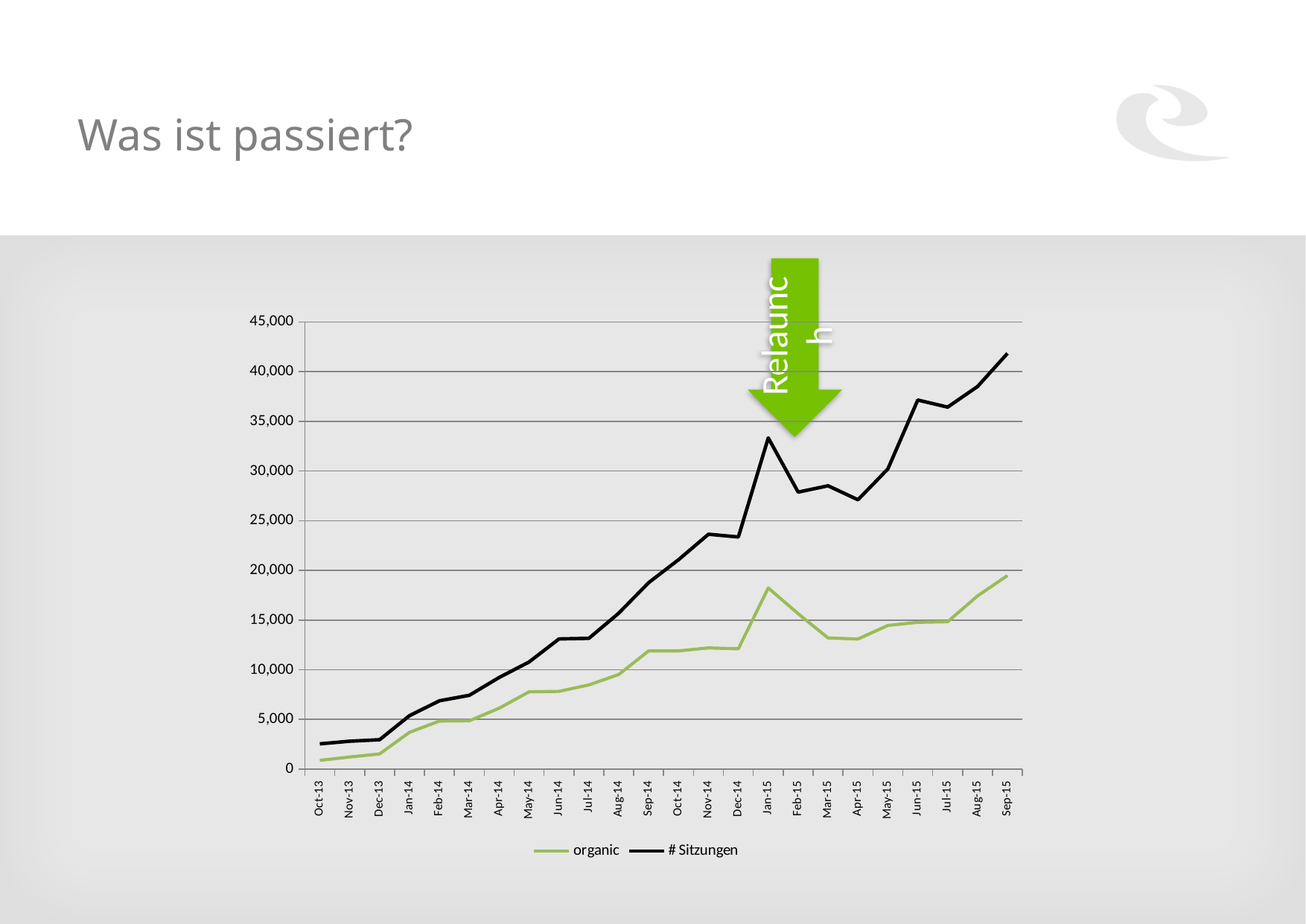
What label is written on the green arrow pointing at the chart? Relaunch Is the value for # Sitzungen in Sep-15 greater or less than 40,000? greater Is the value for # Sitzungen in Apr-15 greater or less than 30,000? less How many months are plotted along the x axis? 24 Does the # Sitzungen series generally rise or fall from Oct-13 to Sep-15? rise Which series has the larger value in Jan-15, organic or # Sitzungen? # Sitzungen How many series does the legend list? 2 Is the value for organic in Jan-15 greater or less than 15,000? greater In which month is the organic series at its lowest value? Oct-13 What kind of chart is shown on the slide? line chart In which month does the # Sitzungen series reach its highest value? Sep-15